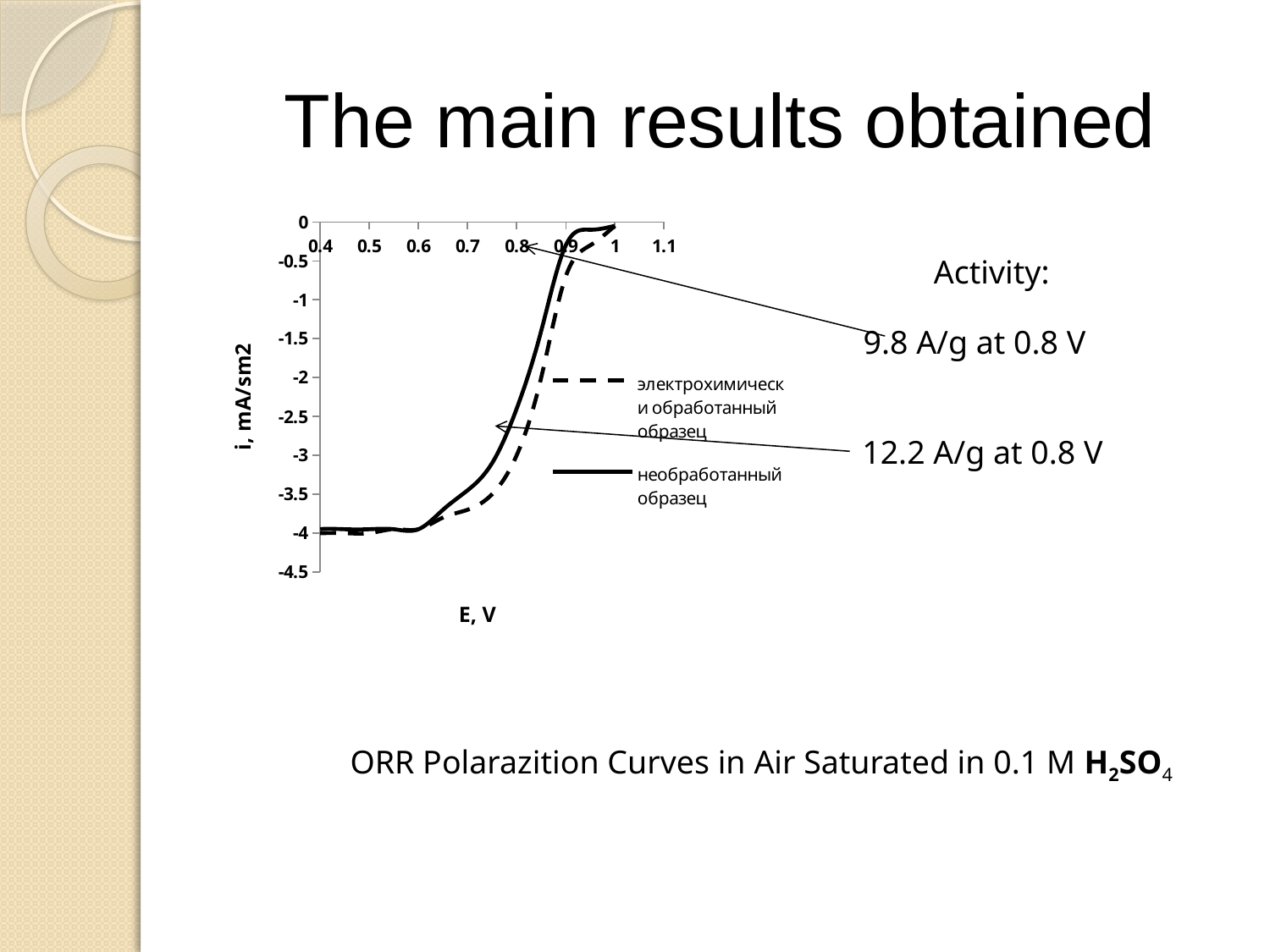
Which annotated activity value is larger, 9.8 A/g or 12.2 A/g? 12.2 A/g What is the label of the x axis of the chart? E, V As E increases from 0.4 V to 1.0 V, do the current values rise or fall? rise At 0.8 V, which series has the higher (less negative) current: необработанный образец or электрохимически обработанный образец? необработанный образец What kind of chart is shown on the slide? line chart What is the difference between the two annotated activity values, 12.2 A/g and 9.8 A/g? 2.4 A/g At what potential are the annotated activity values reported? 0.8 V At 0.5 V, is the value for необработанный образец greater or less than -3.5? less At 1.0 V, is the value for электрохимически обработанный образец greater or less than -2? greater What are the two legend entries of the chart? электрохимически обработанный образец; необработанный образец What is the lowest tick value shown on the y axis of the chart? -4.5 How many series does the chart's legend list? 2